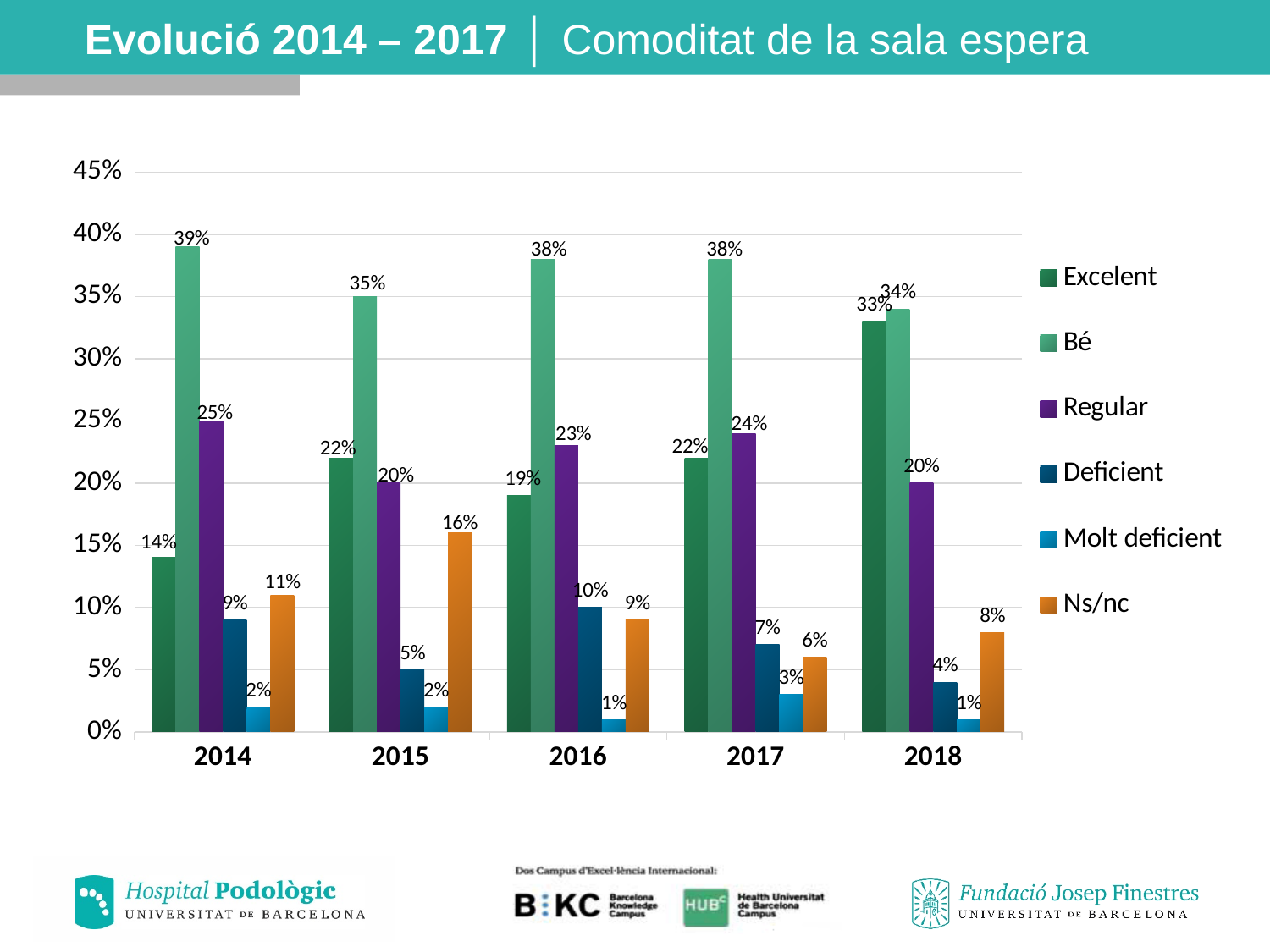
How many years are shown on the x axis? 5 What is the value for Ns/nc in 2015? 16% What is the value for Excelent in 2018? 33% What kind of chart is shown on the slide? bar chart In which year is the Excelent value highest? 2018 In which year is the Ns/nc value lowest? 2017 Which series is shown in orange in the legend? Ns/nc Does the Excelent value rise or fall from 2014 to 2015? rise What is the difference between the Bé and Excelent values in 2018? 1% How many series does the legend list? 6 Which is larger in 2016: Regular or Deficient? Regular What is the value for Bé in 2014? 39%